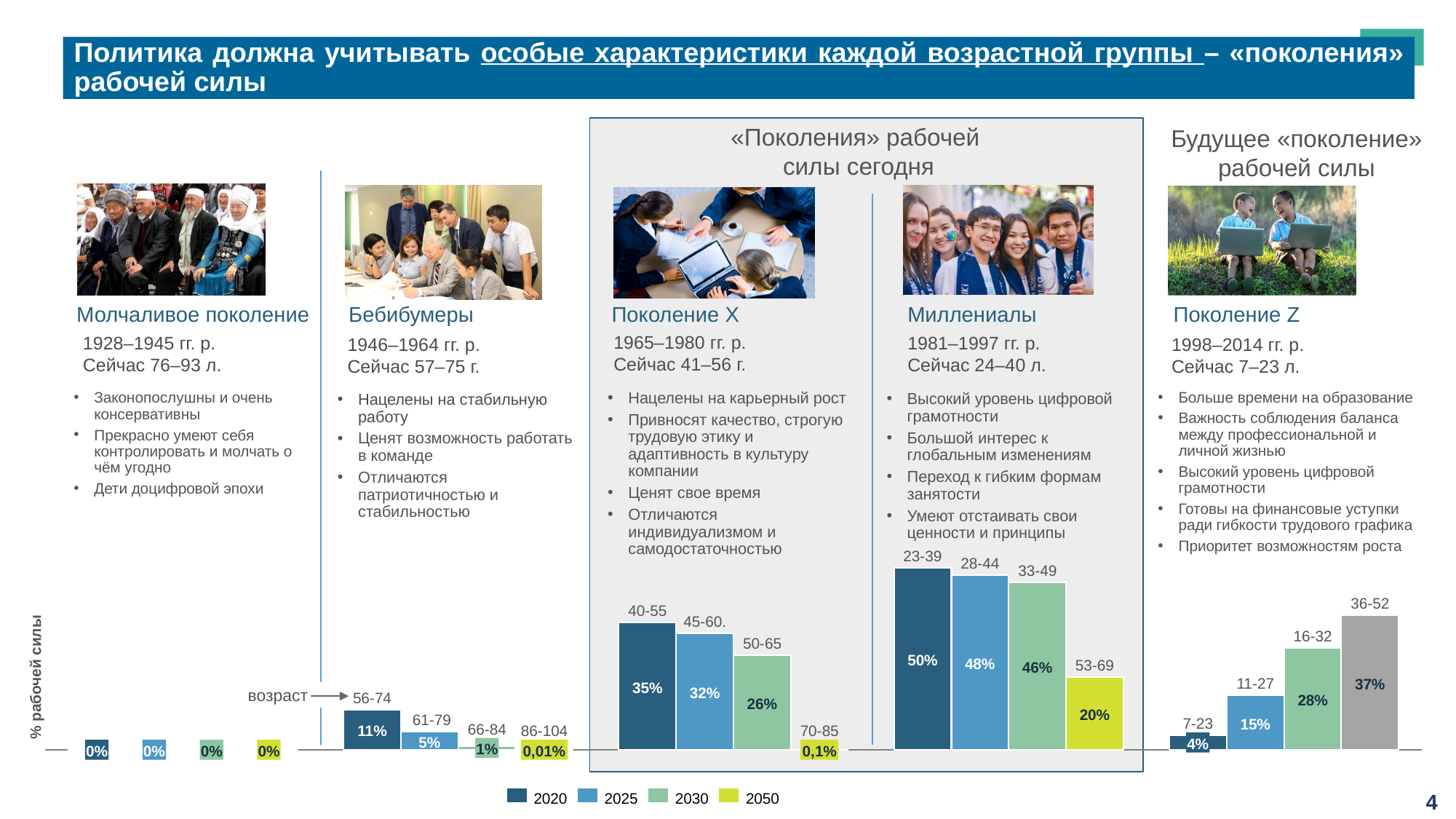
Which colour represents the year 2050 in the legend? yellow-green How many years (series) does the legend list? 4 What share of the workforce does Generation X (Поколение X) make up in 2030? 26% What share of the workforce do Baby Boomers (Бебибумеры) make up in 2025? 5% Which generation has the highest share of the workforce in 2050? Поколение Z What type of chart is used to show the workforce shares by generation? bar chart Which is larger in 2025: the share for Generation X (Поколение X) or for Millennials (Миллениалы)? Миллениалы Which generation has the highest share of the workforce in 2020? Миллениалы What is the difference between the 2020 and 2050 shares for Generation Z (Поколение Z)? 33 percentage points What share of the workforce do Millennials (Миллениалы) make up in 2020? 50% What share of the workforce does Generation Z (Поколение Z) make up in 2050? 37% Do the workforce shares for Generation Z (Поколение Z) rise or fall from 2020 to 2050? rise